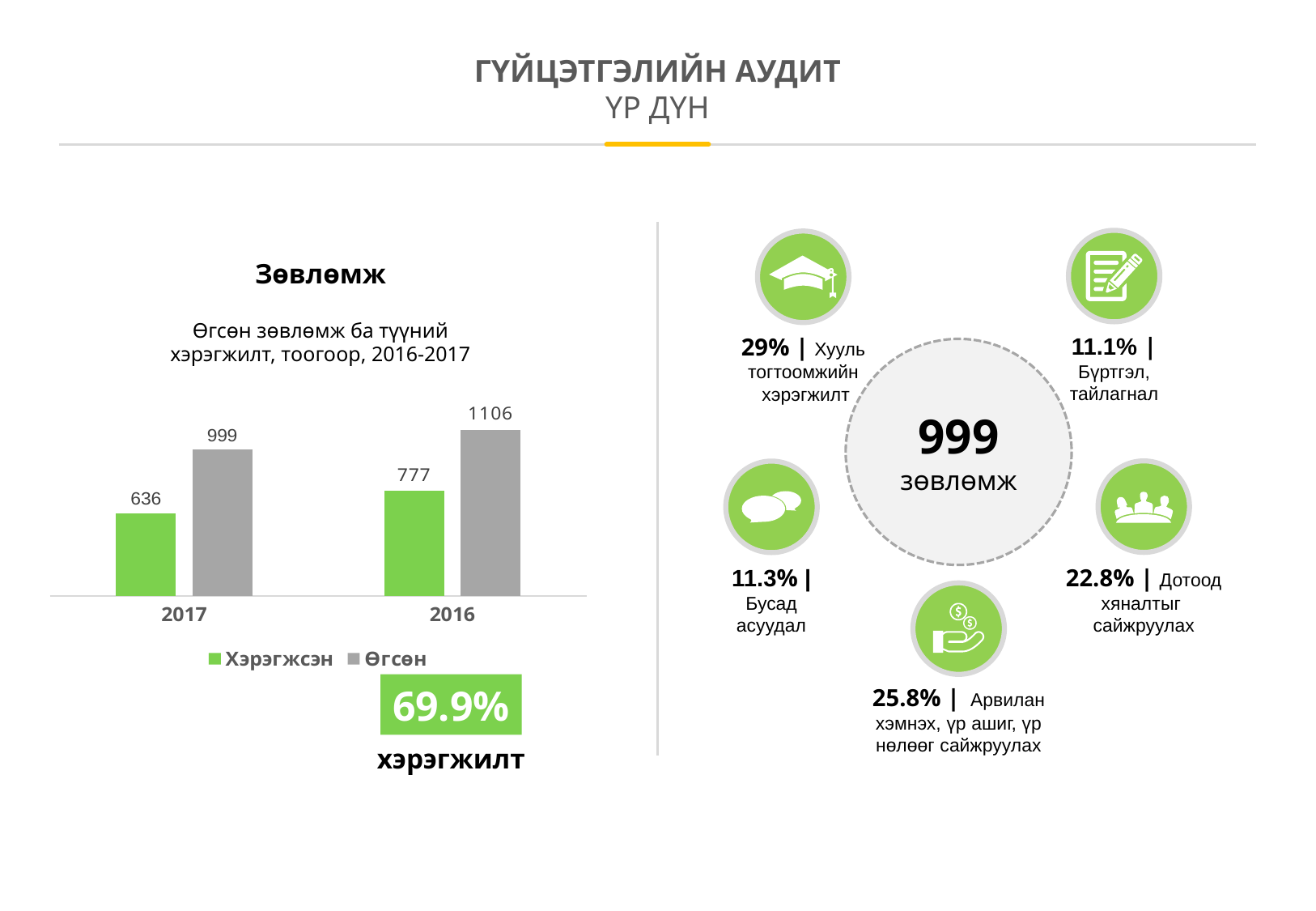
What is the value of Хэрэгжсэн for 2016 in the bar chart? 777 How many series does the legend of the bar chart list? 2 In the bar chart, which is larger: Хэрэгжсэн for 2016 or Өгсөн for 2017? Өгсөн for 2017 What is the value of Өгсөн for 2017 in the bar chart? 999 In the bar chart, what is the difference between Өгсөн and Хэрэгжсэн for 2016? 329 What type of chart is shown on the left of the slide? Bar chart In the bar chart, which year has the lowest Хэрэгжсэн value? 2017 What is the value of Өгсөн for 2016 in the bar chart? 1106 What colour are the Хэрэгжсэн bars in the bar chart? Green In the bar chart, which year has the highest Өгсөн value? 2016 In the bar chart, what is the difference between Өгсөн and Хэрэгжсэн for 2017? 363 What is the value of Хэрэгжсэн for 2017 in the bar chart? 636